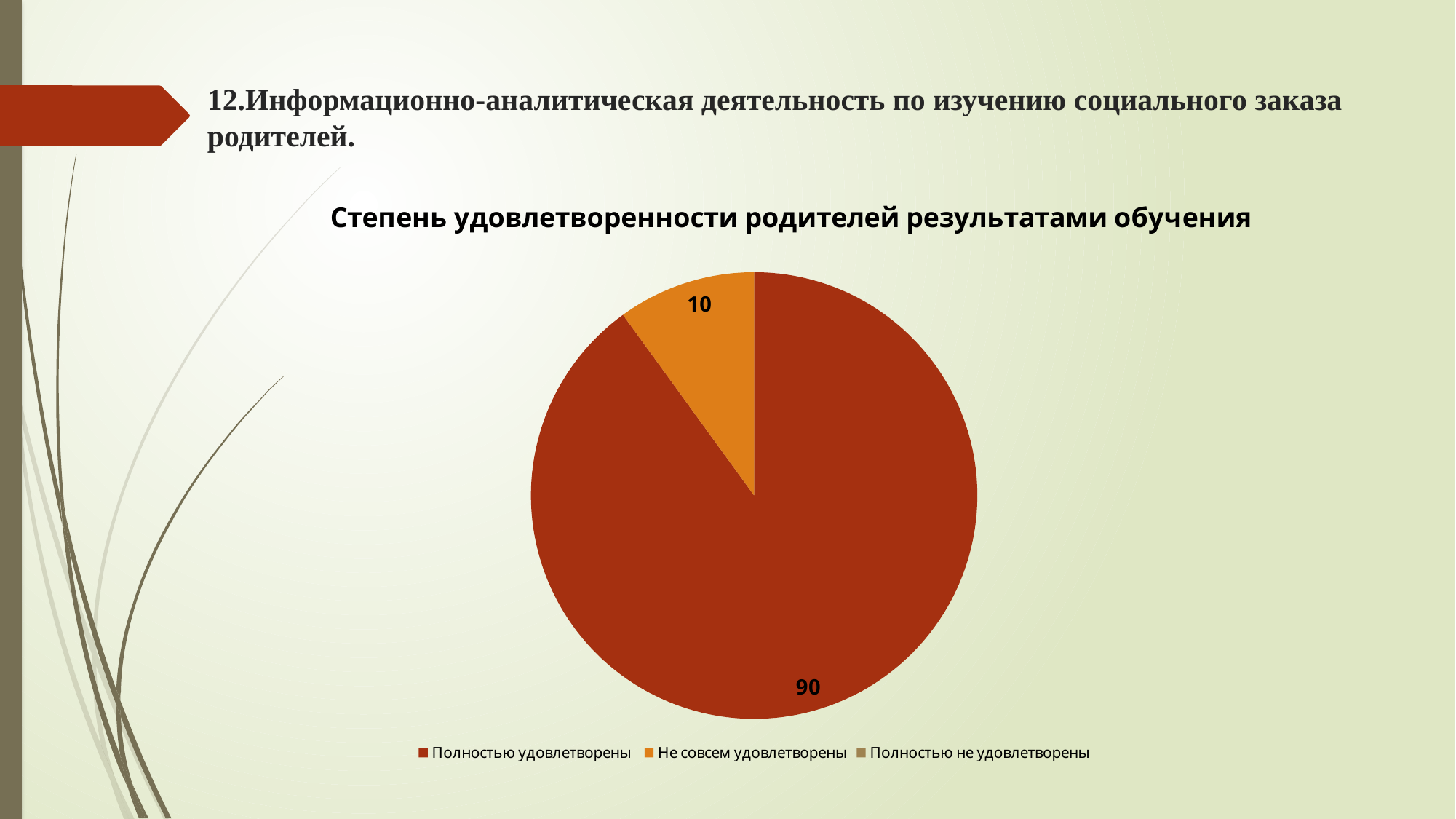
What colour is the "Не совсем удовлетворены" slice in the pie chart? Orange Which category has the largest slice in the pie chart? Полностью удовлетворены What value is shown for the "Полностью удовлетворены" slice of the pie chart? 90 Which is larger: the value for "Полностью удовлетворены" or for "Не совсем удовлетворены"? Полностью удовлетворены What value is shown for the "Не совсем удовлетворены" slice of the pie chart? 10 How many categories does the legend of the pie chart list? 3 What is the difference between the values for "Полностью удовлетворены" and "Не совсем удовлетворены"? 80 How many slices are visibly labelled with a value in the pie chart? 2 What is the title of the pie chart? Степень удовлетворенности родителей результатами обучения What kind of chart is shown on the slide? Pie chart